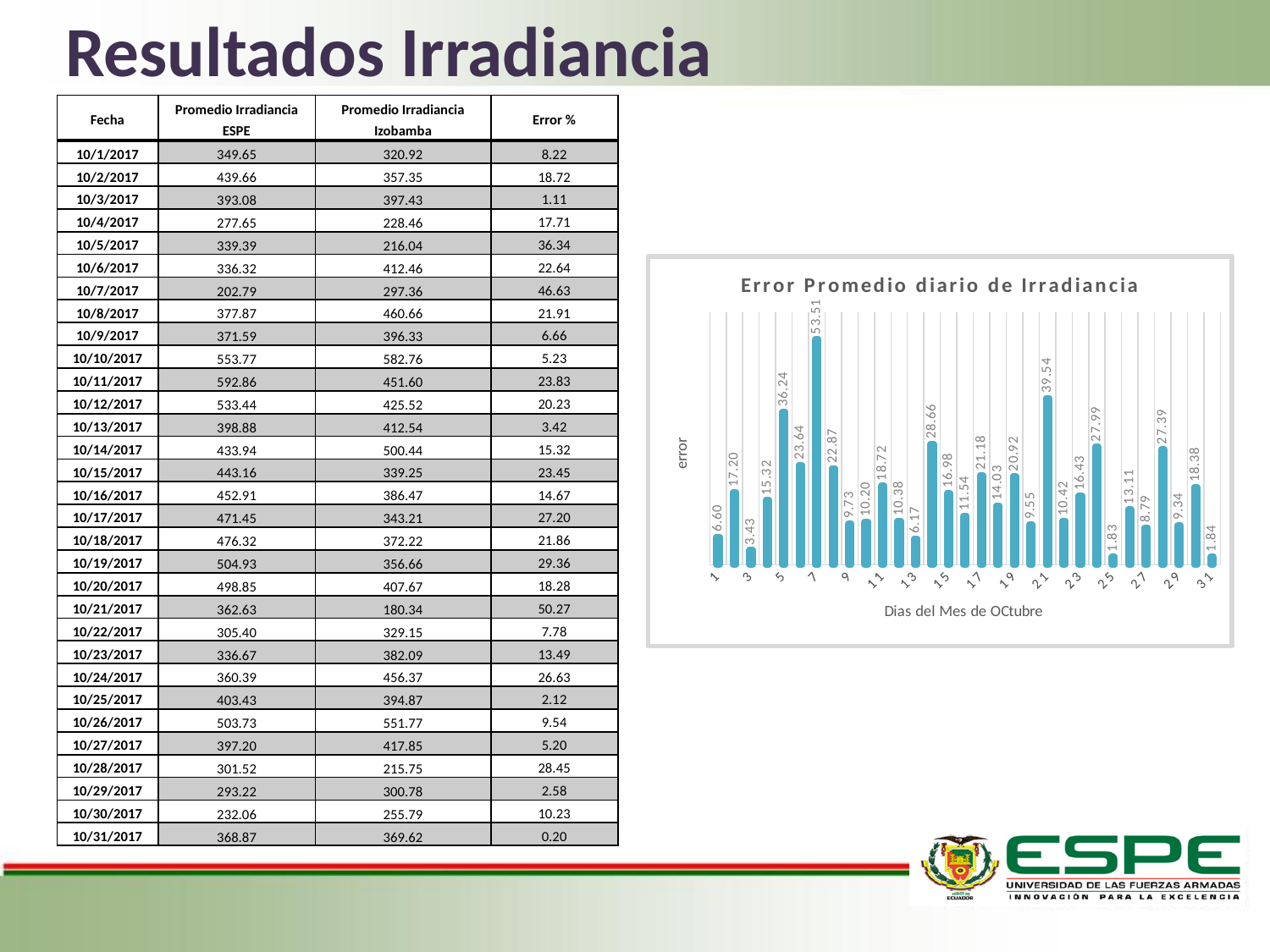
In the chart, what is the error value for day 1? 6.60 In the chart, what is the difference between the error values for day 7 and day 21? 13.97 Which day has the highest error value in the chart? 7 In the chart, which has a larger error value, day 5 or day 21? day 21 In the chart, what is the error value for day 14? 28.66 What is the title of the chart on the slide? Error Promedio diario de Irradiancia In the chart, what is the difference between the error values for day 5 and day 6? 12.60 In the chart, what is the error value for day 7? 53.51 What type of chart is shown on the slide? bar chart In the chart, what is the error value for day 21? 39.54 What is the x-axis title of the chart? Dias del Mes de OCtubre How many bars (days) are plotted in the chart? 31